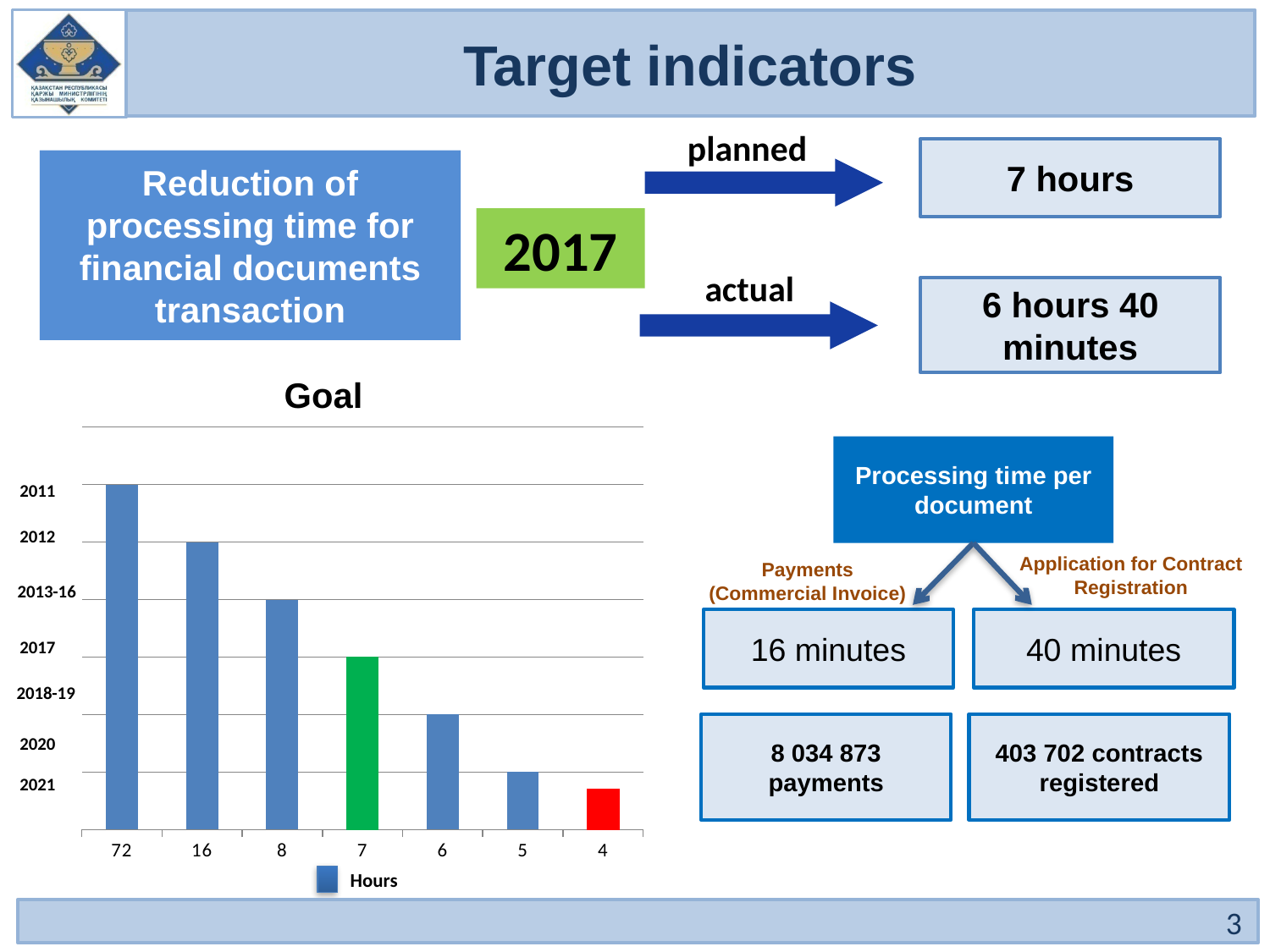
In the "Goal" chart, do the bars rise or fall from left to right along the x axis? fall In the "Goal" chart, which x-axis label has the bar that reaches the 2017 gridline? 7 What type of chart is shown under the title "Goal"? bar chart What is the legend entry of the "Goal" chart? Hours In the "Goal" chart, which year label does the bar labelled 72 reach? 2011 In the "Goal" chart, is the bar labelled 16 taller or shorter than the bar labelled 8? taller In the "Goal" chart, which x-axis label has the shortest bar? 4 What is the title of the chart on the left of the slide? Goal In the "Goal" chart, which x-axis label has the tallest bar? 72 In the "Goal" chart, which year label does the bar labelled 4 reach? 2021 How many series does the legend of the "Goal" chart list? 1 How many bars are plotted in the "Goal" chart? 7